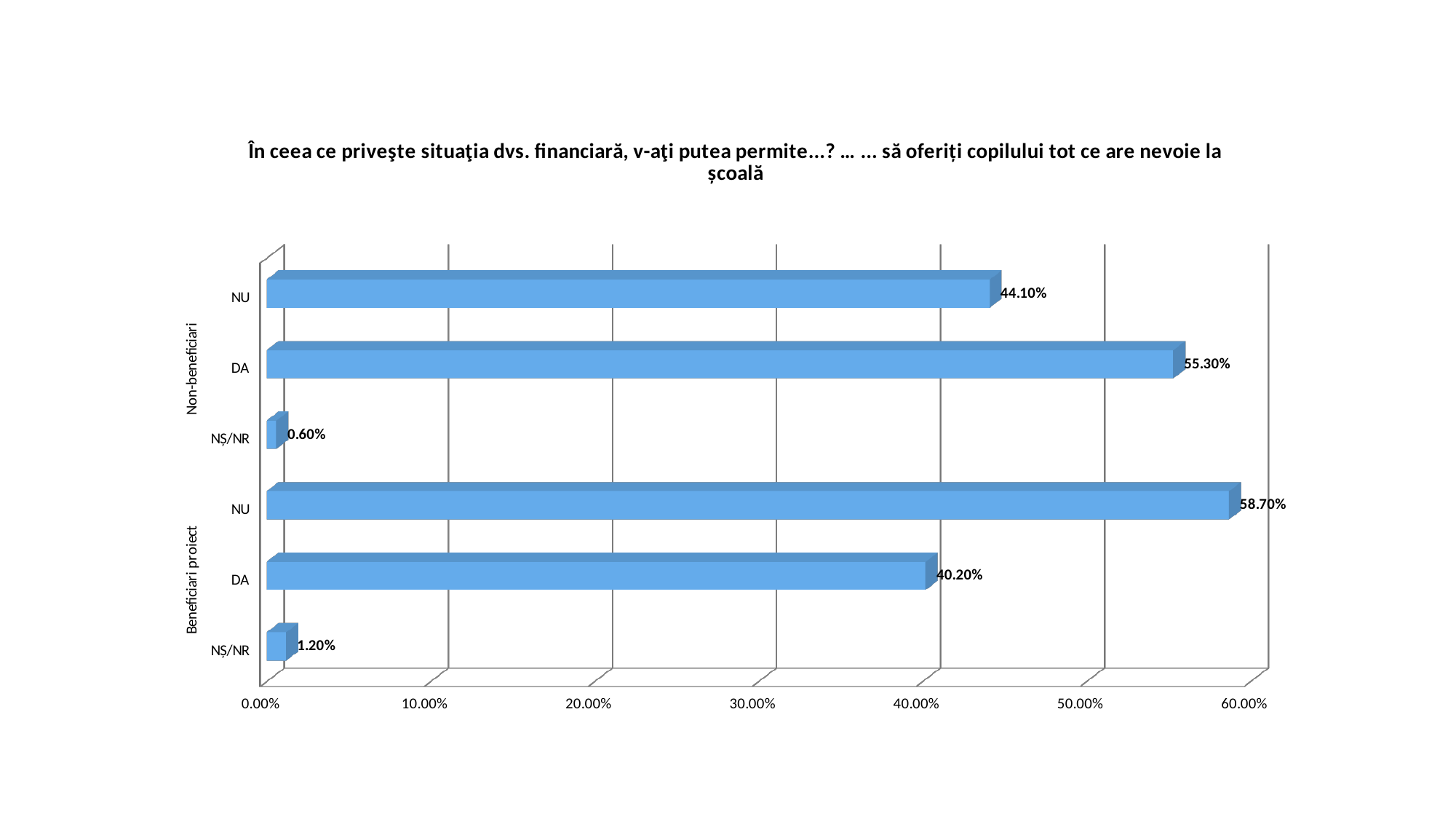
Which is larger: DA for Beneficiari proiect or DA for Non-beneficiari? DA for Non-beneficiari Which bar has the highest value on the chart? NU (Beneficiari proiect) What is the difference between the NU values for Beneficiari proiect and Non-beneficiari? 14.60% What are the two group labels shown on the vertical axis? Non-beneficiari and Beneficiari proiect What type of chart is shown on the slide? Bar chart What is the value for NU in the Non-beneficiari group? 44.10% How many bars are plotted on the chart? 6 What is the value for DA in the Non-beneficiari group? 55.30% What is the value for NU in the Beneficiari proiect group? 58.70% What is the difference between DA and NU in the Non-beneficiari group? 11.20% Which bar has the lowest value on the chart? NȘ/NR (Non-beneficiari) What is the value for NȘ/NR in the Beneficiari proiect group? 1.20%